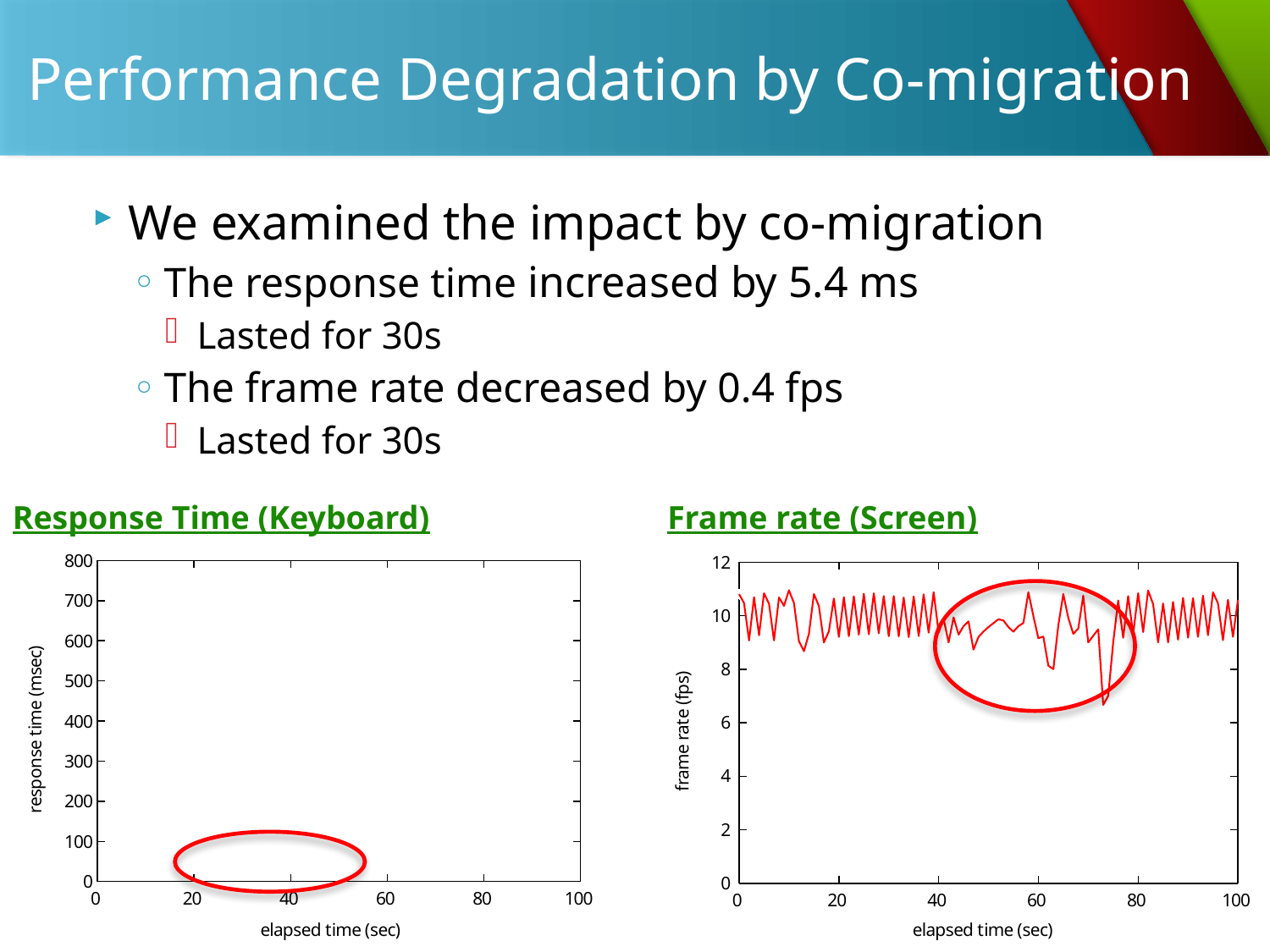
In the Frame rate (Screen) chart, roughly in which elapsed-time range does the circled dip in frame rate occur: between 0 and 20 sec or between 40 and 80 sec? between 40 and 80 sec What is the x-axis label of the Frame rate (Screen) chart? elapsed time (sec) In the Frame rate (Screen) chart, is the frame rate at an elapsed time of 20 sec greater or less than 8? greater In the Frame rate (Screen) chart, is the frame rate at an elapsed time of 90 sec greater or less than 6? greater What kind of chart is the Frame rate (Screen) chart? line chart What is the highest value shown on the y-axis of the Response Time (Keyboard) chart? 800 In the Frame rate (Screen) chart, is the lowest frame rate value reached greater or less than 8? less